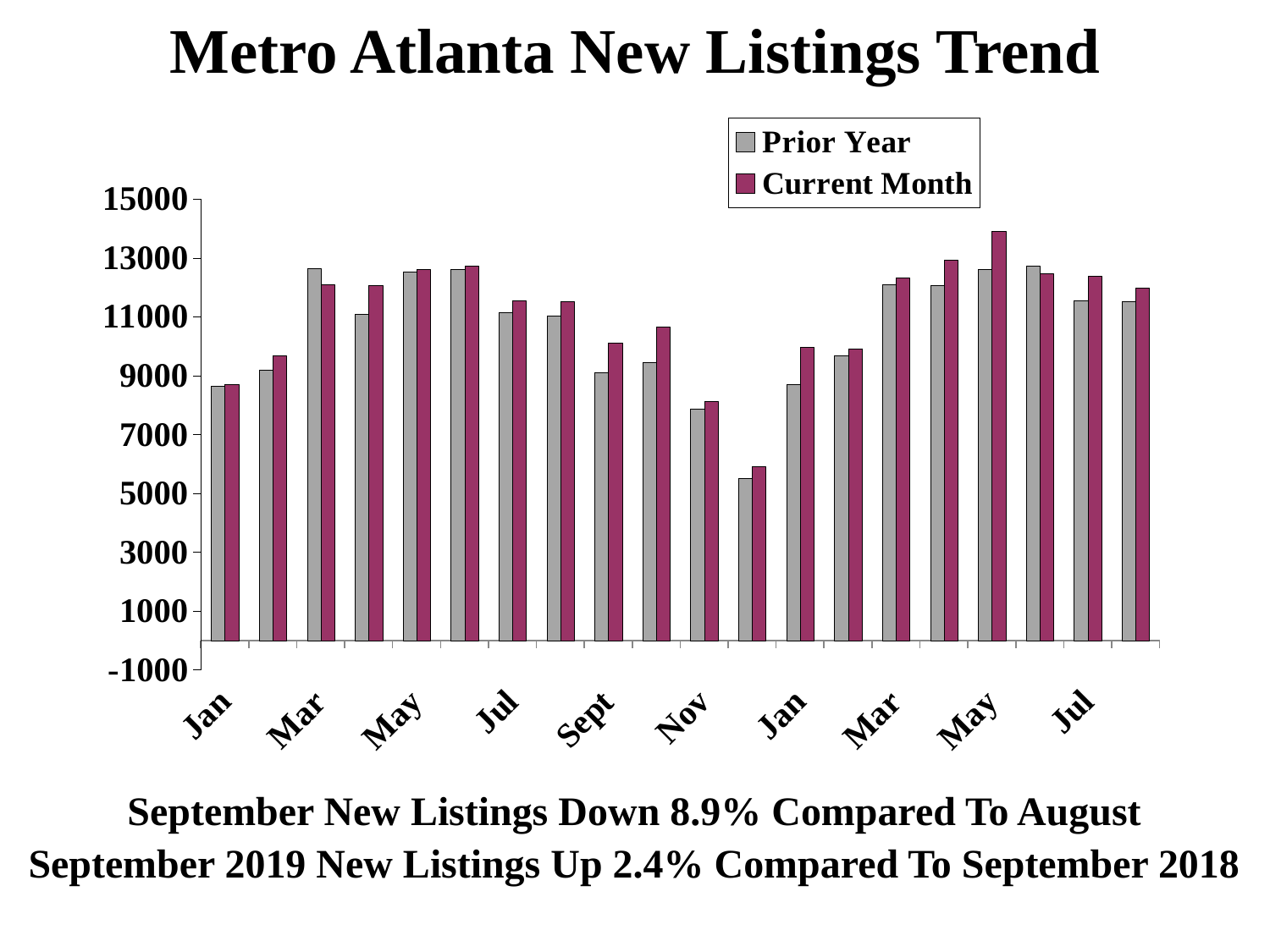
What kind of chart is shown on the slide? bar chart How many month labels are printed on the x axis? 10 Which month has the lowest Prior Year value? Dec (the month between Nov and the second Jan) How many series does the legend list? 2 What are the two series named in the legend? Prior Year and Current Month Is the Current Month value for Nov greater or less than 9000? less Which month has the highest Current Month value? May (second year) What is the title of the chart? Metro Atlanta New Listings Trend Is the Current Month value for Sept greater or less than 9000? greater For the second May, which series has the larger value, Prior Year or Current Month? Current Month Is the Prior Year value for the first Jan greater or less than 9000? less